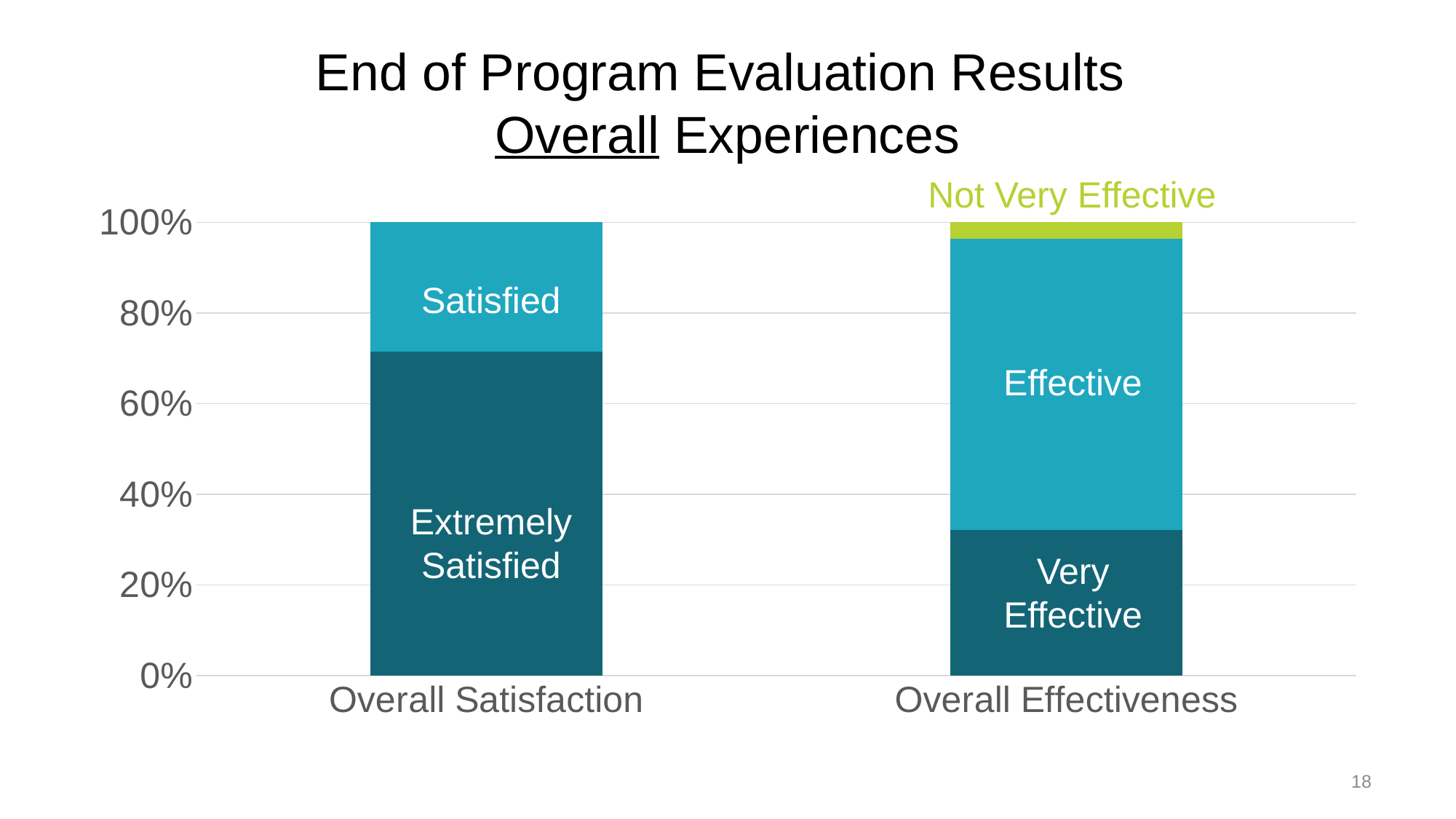
What is the total height of the Overall Satisfaction stacked bar? 100% Is the Not Very Effective segment of the Overall Effectiveness bar greater or less than 20%? less What kind of chart is shown on the slide? Stacked bar chart How many categories are shown on the x axis? 2 How many segments make up the Overall Satisfaction bar? 2 Is the Satisfied segment of the Overall Satisfaction bar greater or less than 40%? less Which segment of the Overall Effectiveness bar is coloured green? Not Very Effective In the Overall Effectiveness bar, which segment is larger: Very Effective or Effective? Effective Is the Very Effective segment of the Overall Effectiveness bar greater or less than 40%? less How many segments make up the Overall Effectiveness bar? 3 In the Overall Satisfaction bar, which segment is larger: Extremely Satisfied or Satisfied? Extremely Satisfied